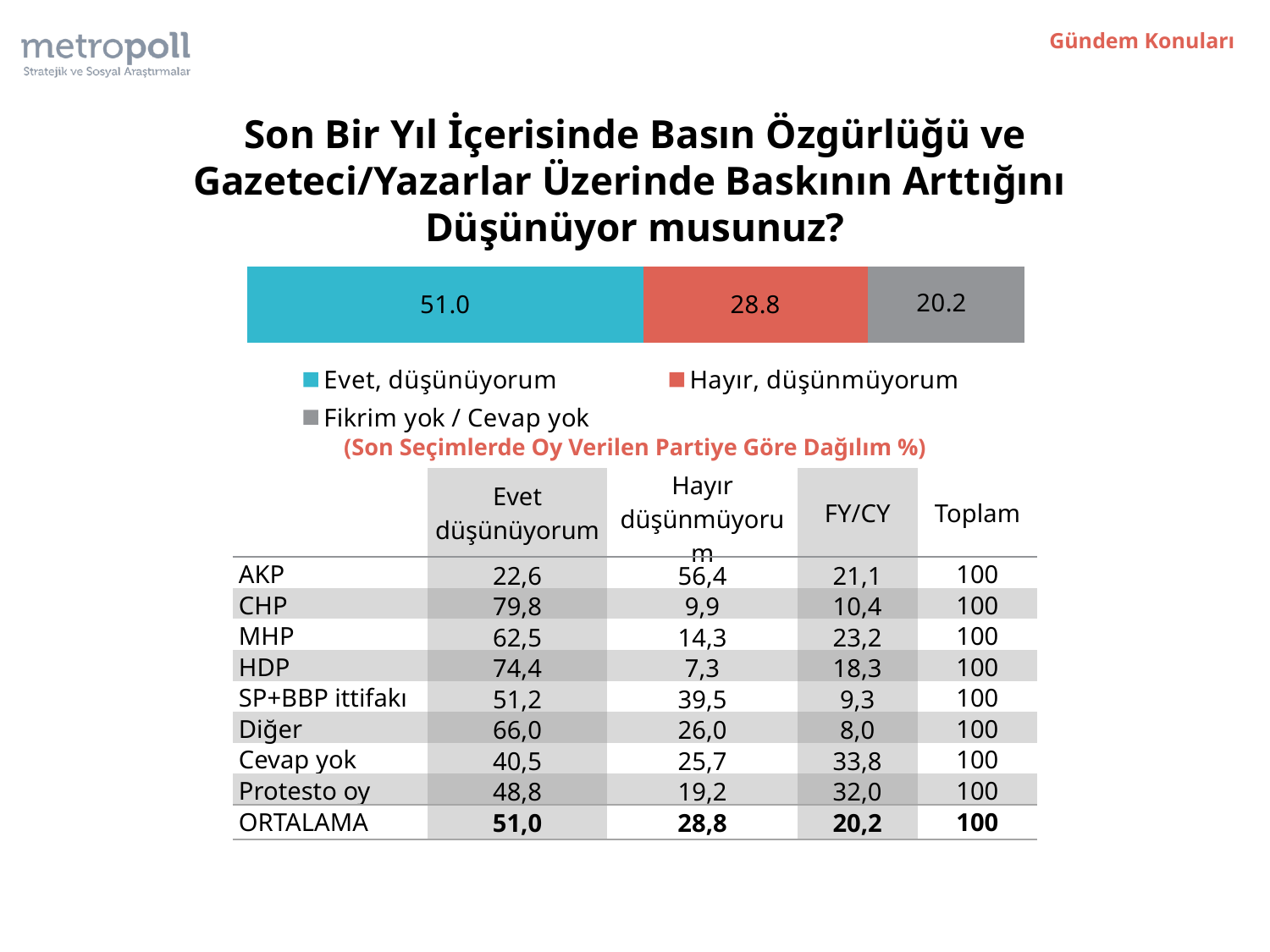
What value is shown for "Fikrim yok / Cevap yok" in the stacked bar chart? 20.2 Which is larger in the stacked bar chart: "Hayır, düşünmüyorum" or "Fikrim yok / Cevap yok"? Hayır, düşünmüyorum What is the difference between the "Evet, düşünüyorum" and "Hayır, düşünmüyorum" values in the stacked bar chart? 22.2 What colour is the "Hayır, düşünmüyorum" segment in the stacked bar chart? Red What value is shown for "Hayır, düşünmüyorum" in the stacked bar chart? 28.8 What kind of chart is shown on the slide? Stacked bar chart Which legend category has the smallest segment in the stacked bar chart? Fikrim yok / Cevap yok What is the total of all segments in the stacked bar chart? 100.0 What value is shown for "Evet, düşünüyorum" in the stacked bar chart? 51.0 How many series does the legend of the stacked bar chart list? 3 What is the difference between the "Hayır, düşünmüyorum" and "Fikrim yok / Cevap yok" values in the stacked bar chart? 8.6 Which legend category has the largest segment in the stacked bar chart? Evet, düşünüyorum